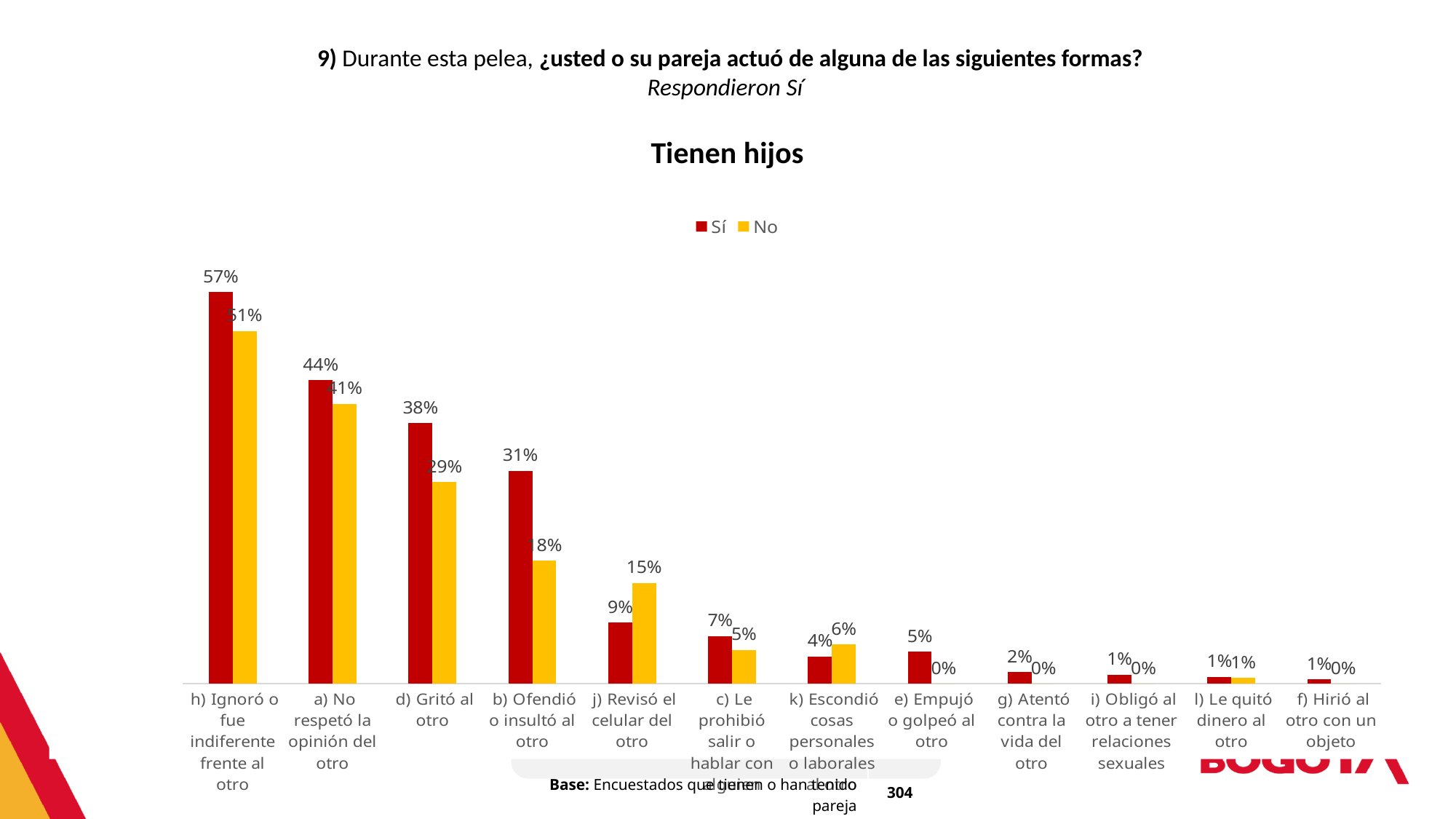
Which category has the highest Sí value? h) Ignoró o fue indiferente frente al otro What is the Sí value for "h) Ignoró o fue indiferente frente al otro"? 57% For "k) Escondió cosas personales o laborales", which is larger, the Sí value or the No value? No For "j) Revisó el celular del otro", which is larger, the Sí value or the No value? No How many categories are shown on the x axis? 12 What is the title of the chart? Tienen hijos What is the No value for "d) Gritó al otro"? 29% What kind of chart is shown? Bar chart What is the difference between the Sí and No values for "d) Gritó al otro"? 9% How many series does the legend list? 2 What is the No value for "j) Revisó el celular del otro"? 15% What is the Sí value for "b) Ofendió o insultó al otro"? 31%